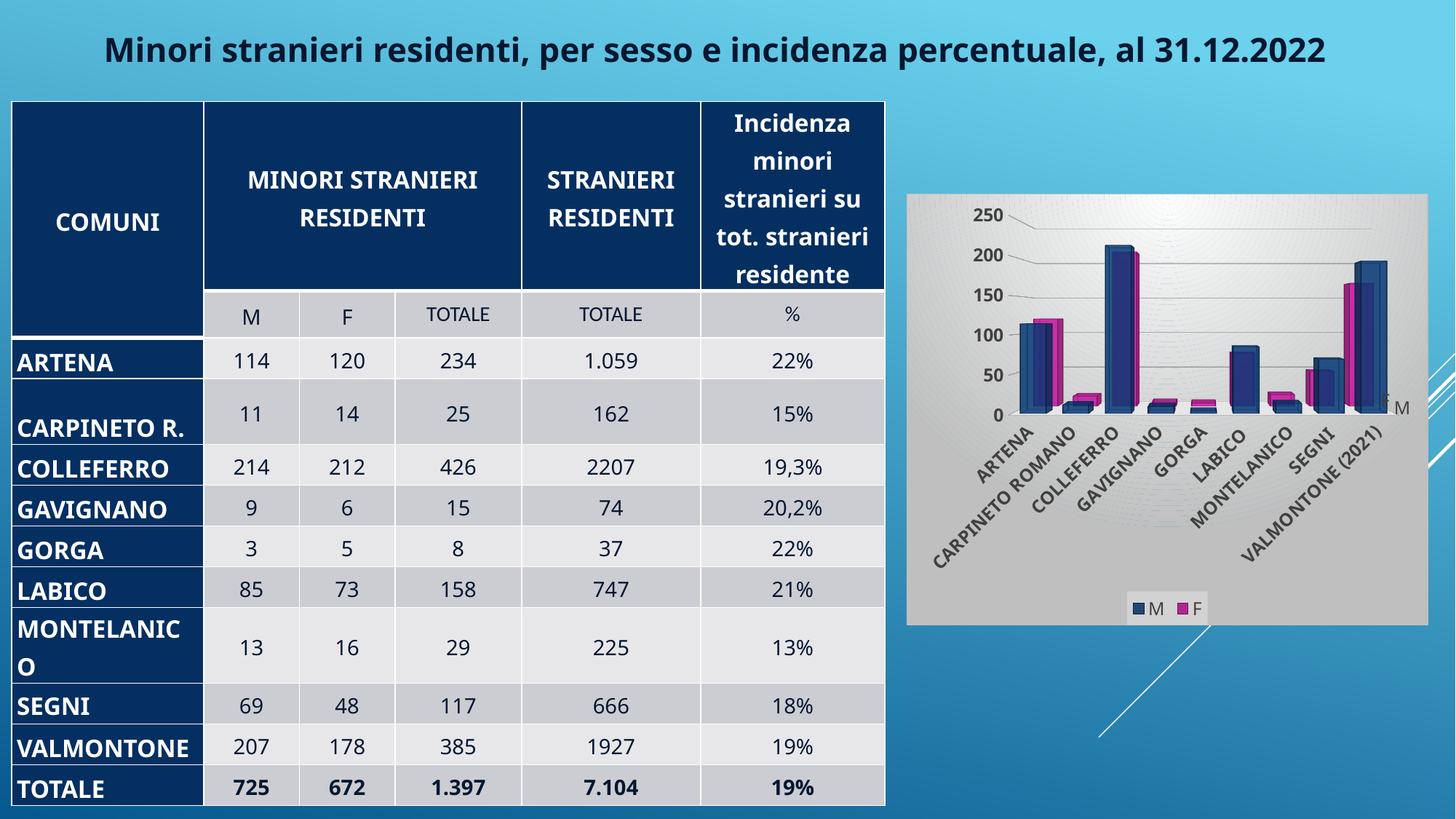
Is the F value for CARPINETO ROMANO in the chart greater or less than 50? less Is the M value for ARTENA in the chart greater or less than 100? greater What kind of chart is shown on the right of the slide? bar chart Is the M value for COLLEFERRO in the chart greater or less than 200? greater In the chart, which is larger for SEGNI: the M bar or the F bar? M Which comune has the highest M bar in the chart? COLLEFERRO How many comuni (categories) are shown on the chart's x axis? 9 What are the two series names shown in the chart's legend? M and F In the chart, which is larger: the M bar for COLLEFERRO or the M bar for ARTENA? COLLEFERRO How many series does the chart's legend list? 2